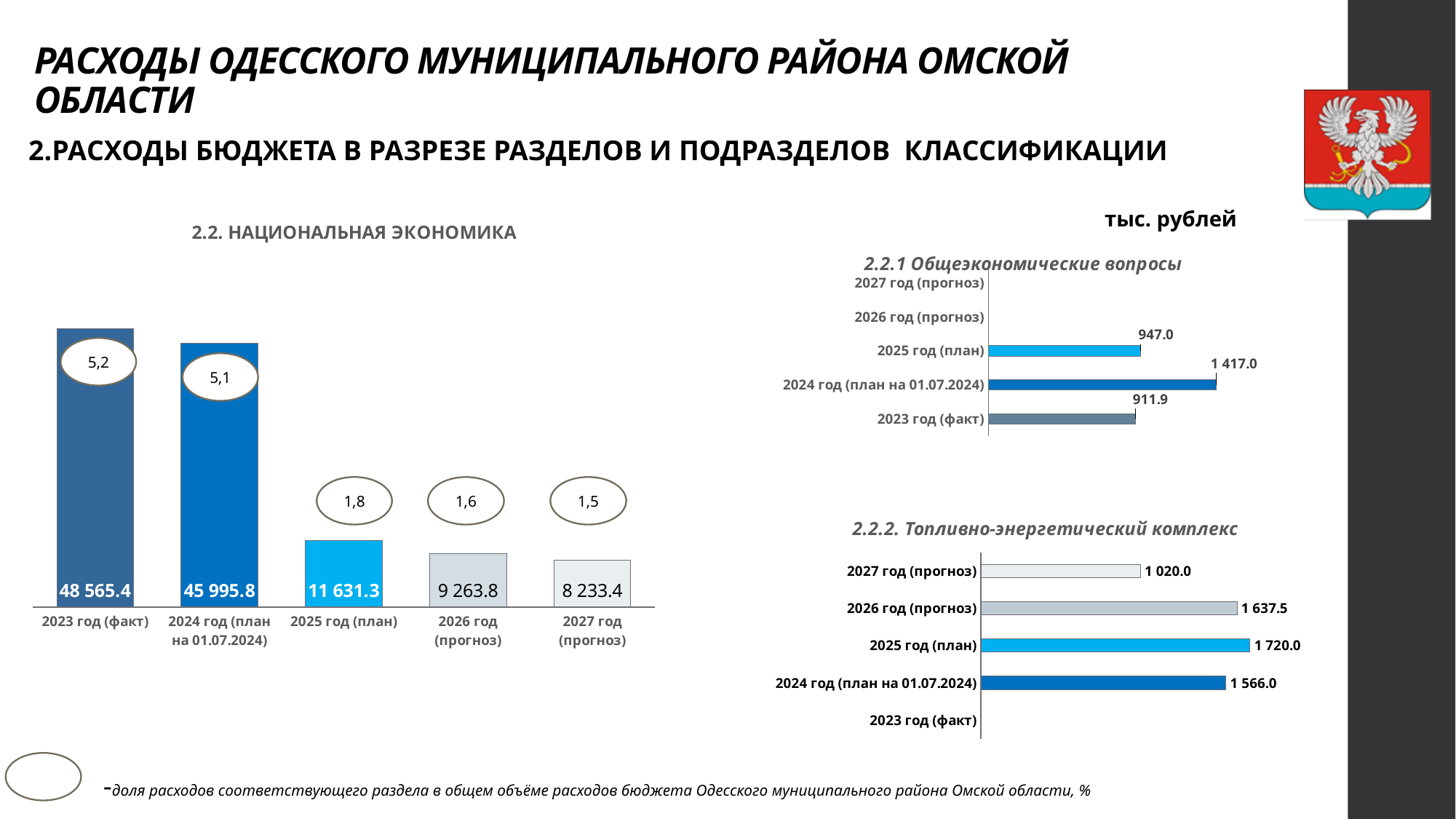
In the chart "2.2.1 Общеэкономические вопросы", which category has the lowest labelled value? 2023 год (факт) In the chart "2.2. НАЦИОНАЛЬНАЯ ЭКОНОМИКА", what is the value for 2023 год (факт)? 48 565.4 In the chart "2.2.1 Общеэкономические вопросы", what is the value for 2024 год (план на 01.07.2024)? 1 417.0 In the chart "2.2. НАЦИОНАЛЬНАЯ ЭКОНОМИКА", do the values rise or fall from 2023 to 2027? fall In the chart "2.2.2. Топливно-энергетический комплекс", what is the value for 2026 год (прогноз)? 1 637.5 In the chart "2.2. НАЦИОНАЛЬНАЯ ЭКОНОМИКА", what is the value for 2027 год (прогноз)? 8 233.4 In the chart "2.2. НАЦИОНАЛЬНАЯ ЭКОНОМИКА", what is the difference between the values for 2023 год (факт) and 2024 год (план на 01.07.2024)? 2 569.6 In the chart "2.2. НАЦИОНАЛЬНАЯ ЭКОНОМИКА", which category has the highest value? 2023 год (факт) In the chart "2.2. НАЦИОНАЛЬНАЯ ЭКОНОМИКА", what share (in %) is shown in the circle above the 2025 год (план) bar? 1,8 In the chart "2.2.1 Общеэкономические вопросы", what is the difference between the values for 2024 год (план на 01.07.2024) and 2025 год (план)? 470.0 What kind of chart is "2.2.2. Топливно-энергетический комплекс"? bar chart In the chart "2.2.2. Топливно-энергетический комплекс", which category has the highest value? 2025 год (план)